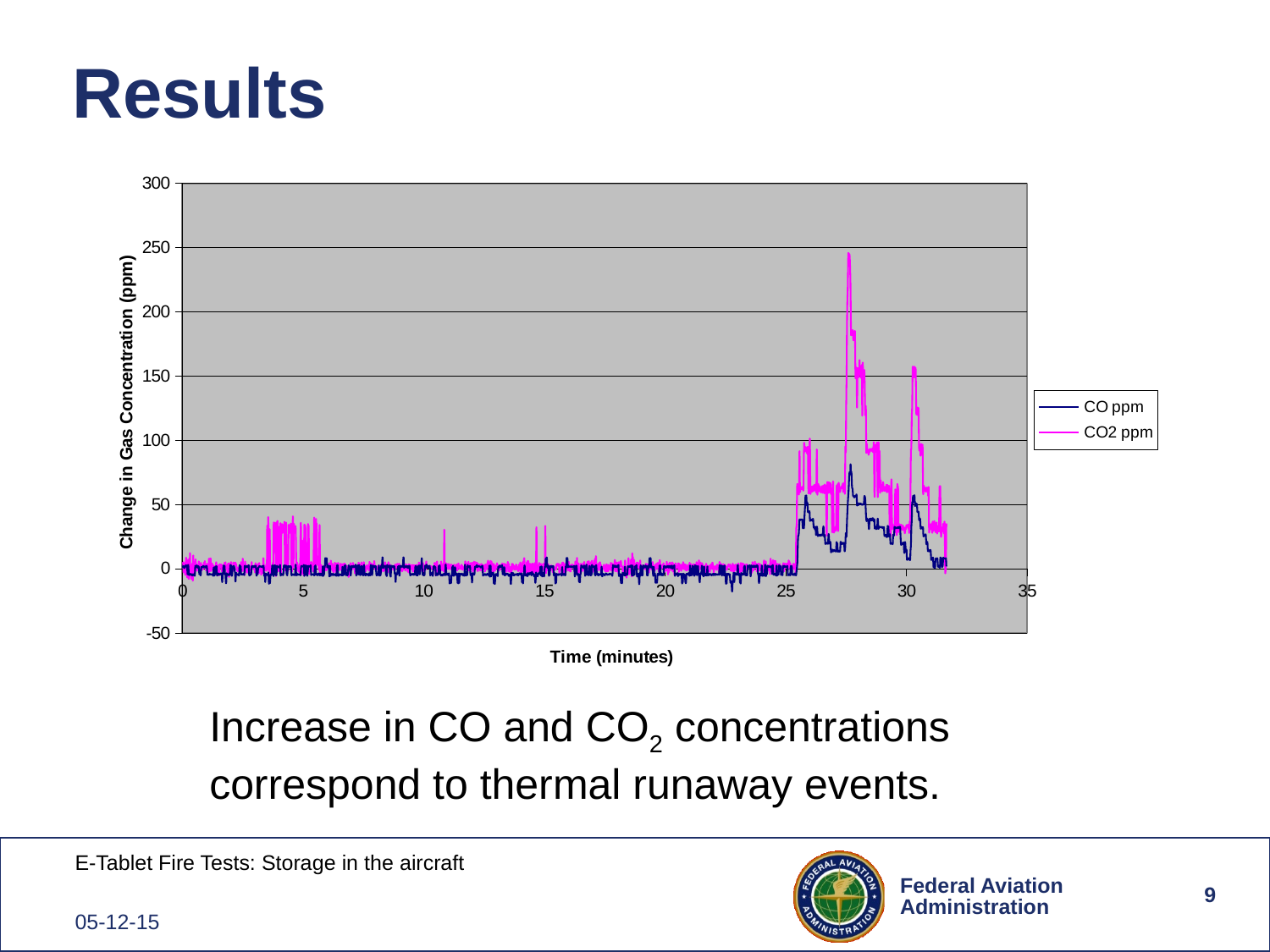
Is the highest peak of the CO ppm series greater or less than 50? greater What are the two series named in the chart's legend? CO ppm and CO2 ppm Is the CO2 ppm value at around 26 minutes greater or less than 50? greater Is the CO2 ppm value at around 20 minutes greater or less than 50? less What is the title of the chart's vertical axis? Change in Gas Concentration (ppm) What kind of chart is shown on the slide? line chart How many series does the chart's legend list? 2 Which series has the higher peak between 25 and 30 minutes, CO ppm or CO2 ppm? CO2 ppm Which series reaches the higher peak value, CO ppm or CO2 ppm? CO2 ppm